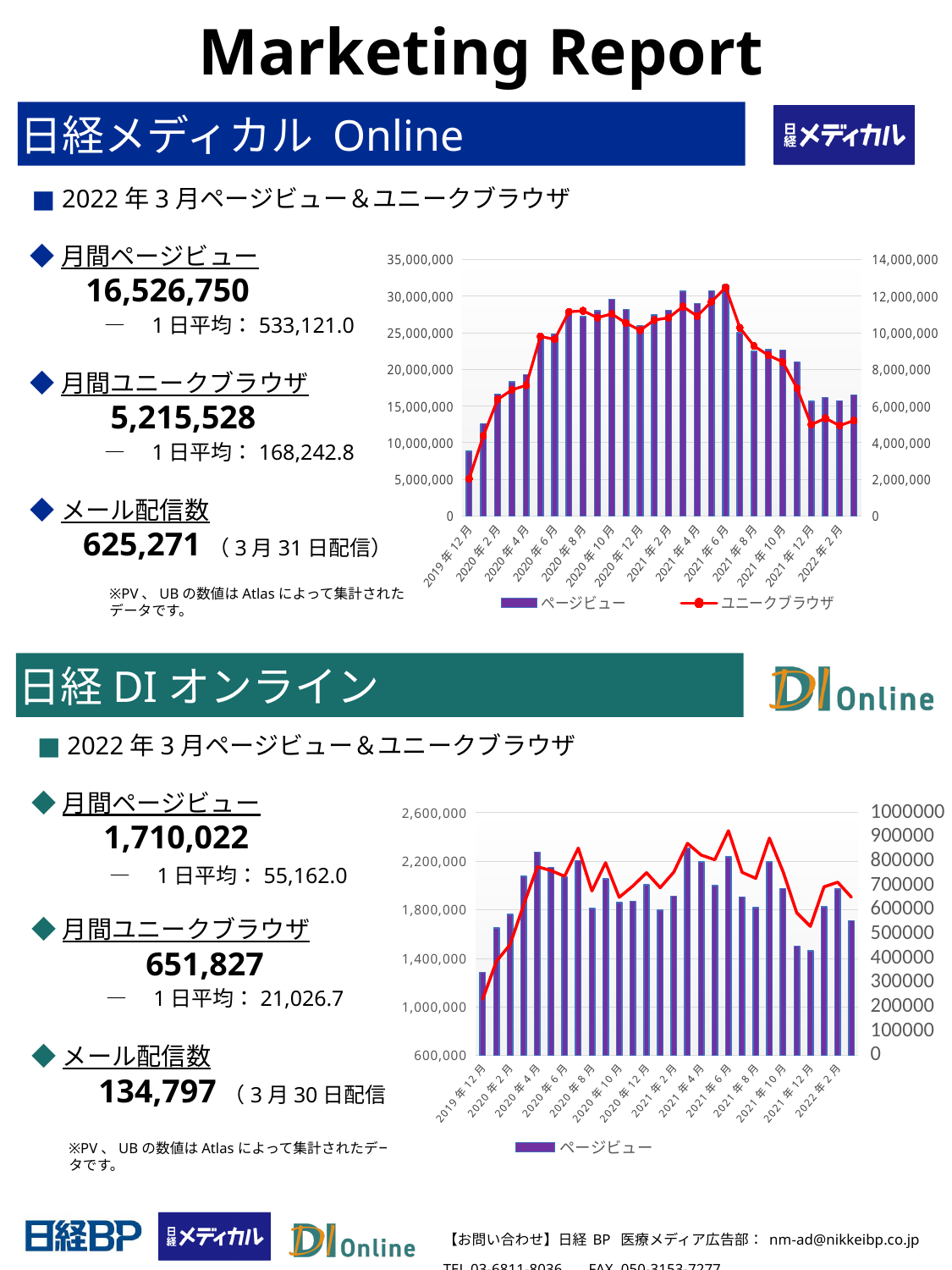
In the 日経DIオンライン chart (bottom), how many series does the legend list? 1 In the 日経メディカル Online chart (top), which month has the lowest ページビュー bar? 2019年12月 In the 日経DIオンライン chart (bottom), do the ページビュー values rise or fall from 2019年12月 to 2020年4月? rise In the 日経メディカル Online chart (top), which is larger, the ページビュー value for 2020年4月 or for 2019年12月? 2020年4月 In the 日経メディカル Online chart (top), how many series does the legend list? 2 In the 日経メディカル Online chart (top), what kind of chart is used to show ページビュー? bar chart In the 日経メディカル Online chart (top), do the ページビュー values rise or fall from 2021年6月 to 2022年2月? fall In the 日経DIオンライン chart (bottom), which month has the lowest ページビュー bar? 2019年12月 In the 日経メディカル Online chart (top), which month has the highest ユニークブラウザ value? 2021年6月 In the 日経メディカル Online chart (top), is the ページビュー value for 2019年12月 greater or less than 15,000,000? less In the 日経DIオンライン chart (bottom), is the ページビュー value for 2019年12月 greater or less than 1,800,000? less In the 日経メディカル Online chart (top), is the ユニークブラウザ value for 2021年6月 greater or less than 10,000,000? greater